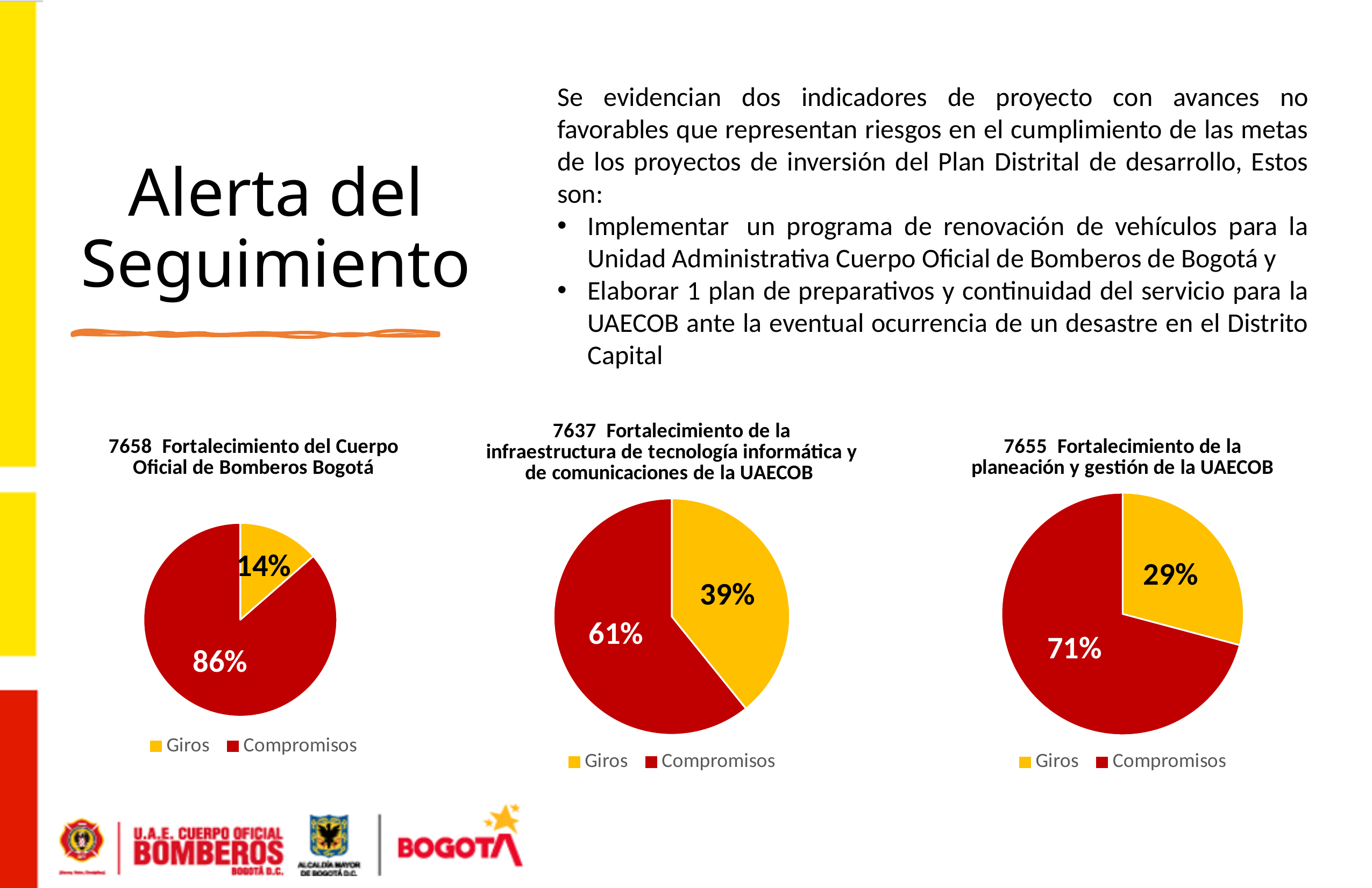
In the chart titled '7637 Fortalecimiento de la infraestructura de tecnología informática y de comunicaciones de la UAECOB', what is the difference in percentage points between Compromisos and Giros? 22 In the chart titled '7658 Fortalecimiento del Cuerpo Oficial de Bomberos Bogotá', which slice is larger, Giros or Compromisos? Compromisos How many slices does the chart titled '7655 Fortalecimiento de la planeación y gestión de la UAECOB' have? 2 In the chart titled '7658 Fortalecimiento del Cuerpo Oficial de Bomberos Bogotá', what colour is the Giros slice? Yellow In the chart titled '7655 Fortalecimiento de la planeación y gestión de la UAECOB', what share of the pie is Giros? 29% In the chart titled '7637 Fortalecimiento de la infraestructura de tecnología informática y de comunicaciones de la UAECOB', what share of the pie is Giros? 39% In the chart titled '7637 Fortalecimiento de la infraestructura de tecnología informática y de comunicaciones de la UAECOB', what share of the pie is Compromisos? 61% What kind of chart is the leftmost chart on the slide? Pie chart In the chart titled '7655 Fortalecimiento de la planeación y gestión de la UAECOB', which slice is the smallest? Giros